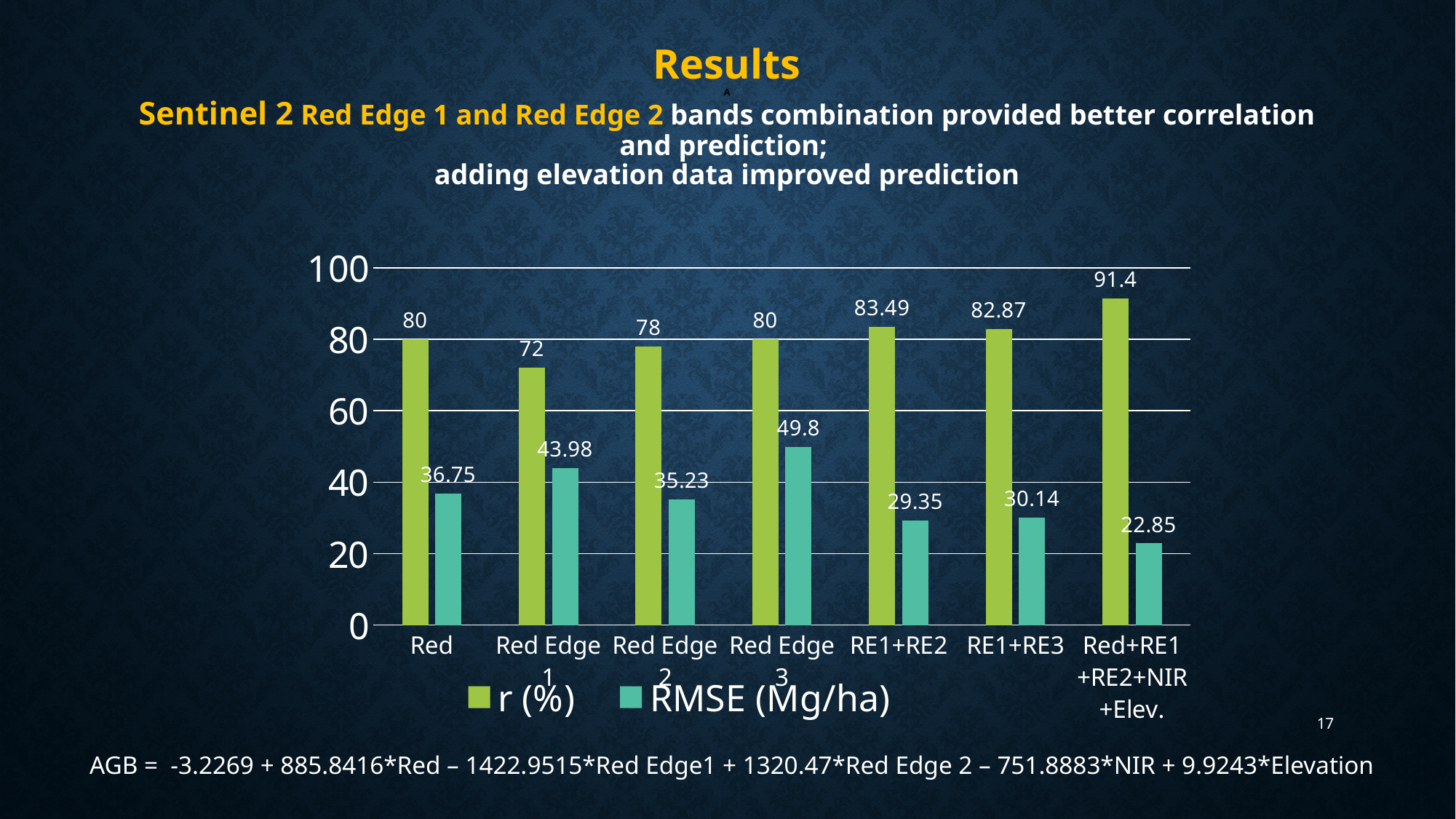
What is the r (%) value for RE1+RE2? 83.49 What is the RMSE (Mg/ha) value for Red Edge 3? 49.8 What is the RMSE (Mg/ha) value for Red+RE1+RE2+NIR+Elev.? 22.85 What kind of chart is shown on the slide? Bar chart Which category has the highest r (%) value? Red+RE1+RE2+NIR+Elev. What are the two series listed in the legend? r (%) and RMSE (Mg/ha) How many categories are shown on the x axis? 7 What is the difference between the r (%) values for Red+RE1+RE2+NIR+Elev. and Red Edge 1? 19.4 Which has a larger RMSE (Mg/ha) value, Red Edge 1 or RE1+RE3? Red Edge 1 Which category has the lowest r (%) value? Red Edge 1 How many series does the legend list? 2 Which category has the lowest RMSE (Mg/ha) value? Red+RE1+RE2+NIR+Elev.